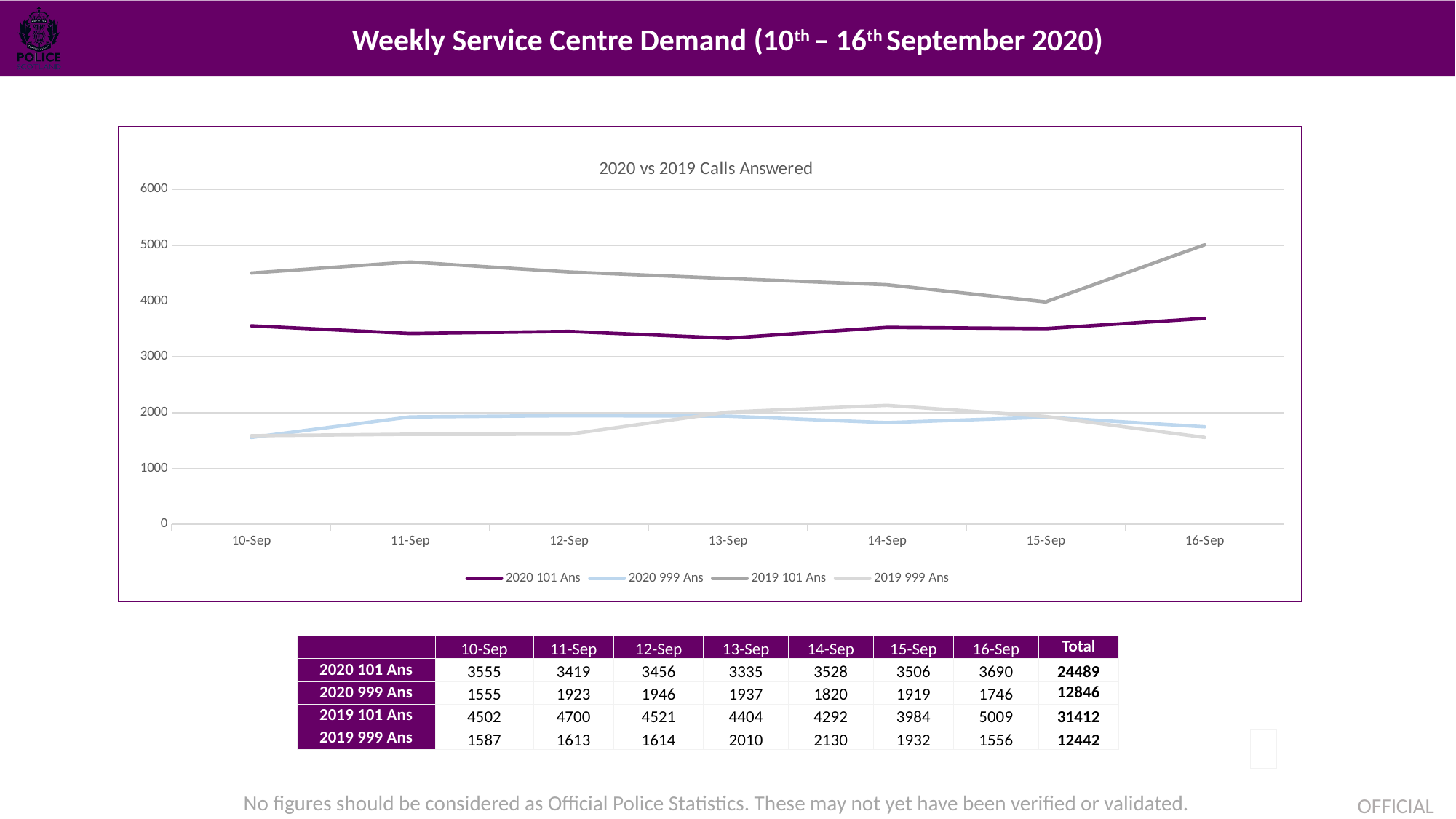
On 14-Sep, which is larger: 2019 999 Ans or 2020 999 Ans? 2019 999 Ans What is the difference between 2019 101 Ans and 2020 101 Ans on 10-Sep? 947 How many series does the chart legend list? 4 What is the title of the chart? 2020 vs 2019 Calls Answered What type of chart is shown on the slide? line chart On which date is 2020 101 Ans at its lowest? 13-Sep Is the value for 2020 999 Ans on 10-Sep greater or less than 2000? less On which date is 2019 101 Ans at its highest? 16-Sep What is the value of 2019 101 Ans on 16-Sep? 5009 What is the value of 2020 999 Ans on 13-Sep? 1937 How many dates are plotted along the x axis of the chart? 7 Does the 2019 101 Ans line rise or fall from 15-Sep to 16-Sep? rise